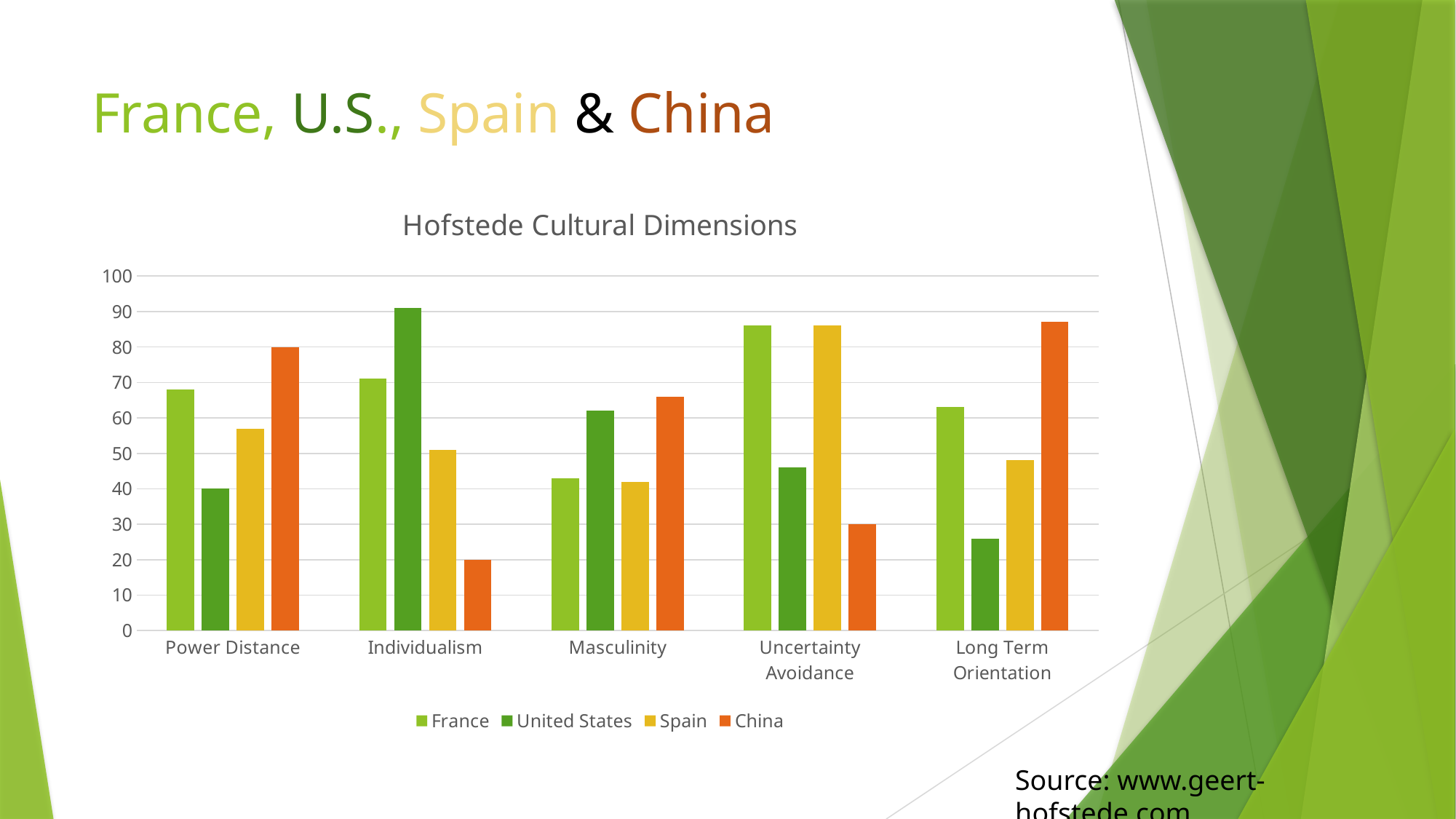
How many series does the legend list? 4 Which country has the lowest value for Uncertainty Avoidance? China Which country has the lowest value for Individualism? China Which country has the highest value for Power Distance? China How many categories are shown on the x axis? 5 Which country has the highest value for Long Term Orientation? China What is the title of the chart? Hofstede Cultural Dimensions Is the value for Spain in Power Distance greater or less than 50? greater For Power Distance, which is larger: the value for France or the value for Spain? France Which country has the highest value for Individualism? United States Is the value for United States in Uncertainty Avoidance greater or less than 50? less What type of chart is shown on the slide? bar chart